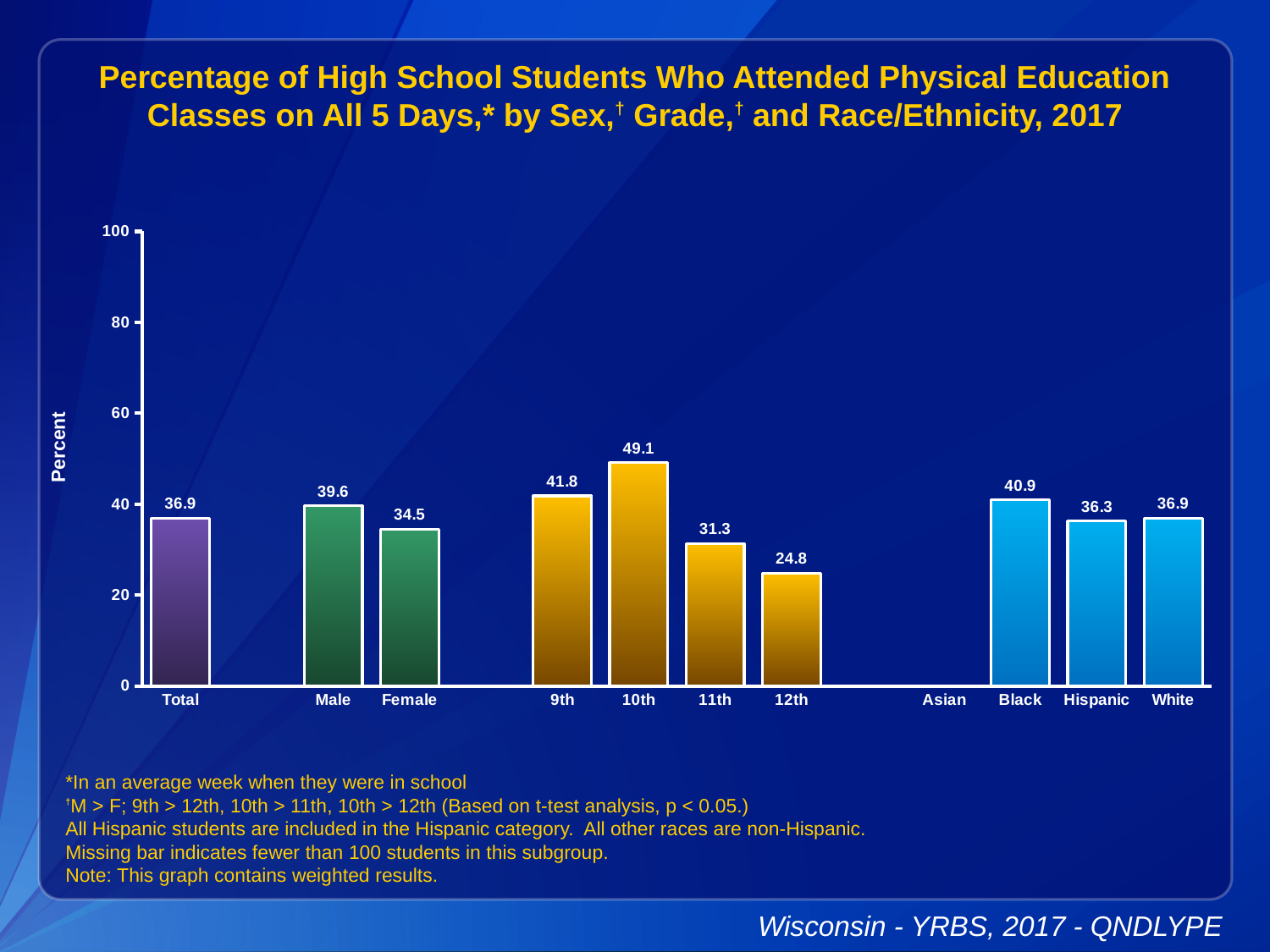
How many bars are plotted on the chart? 10 Which category has the lowest plotted value? 12th What is the value for 12th grade? 24.8 Is the value for 9th grade greater or less than 40? greater What kind of chart is shown on the slide? bar chart Which is larger, the value for Black or the value for White? Black What is the value for Male? 39.6 What is the difference between the values for 10th and 11th grade? 17.8 Which category has the highest value? 10th What is the difference between the values for Male and Female? 5.1 Which race/ethnicity category has no bar plotted? Asian What is the value for Hispanic students? 36.3